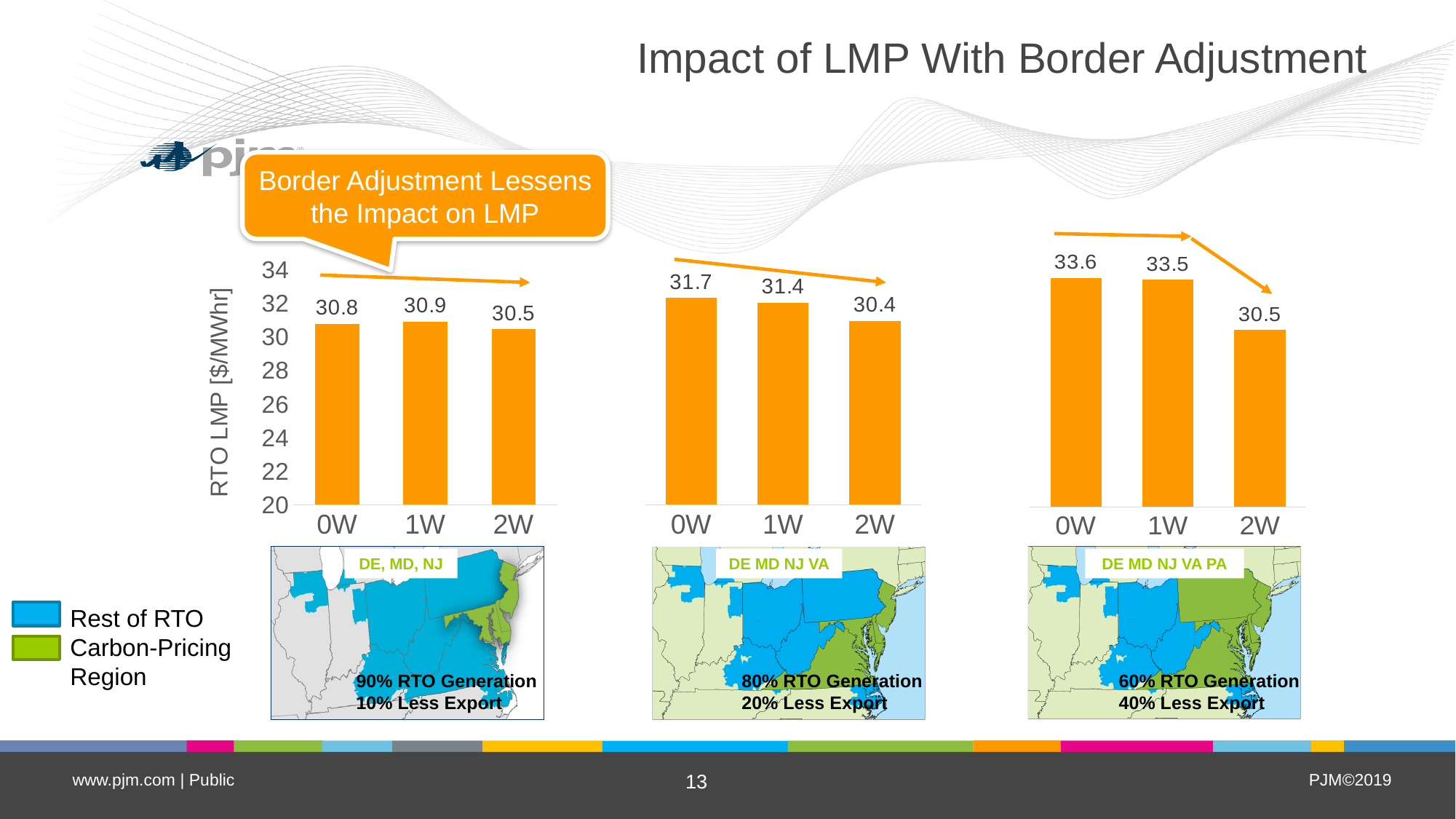
In the right chart (DE MD NJ VA PA), is the value for 1W greater or less than 32? greater How many categories are shown on the x axis of the left chart (DE, MD, NJ)? 3 What is the y-axis label of the charts on this slide? RTO LMP [$/MWhr] In the right chart (DE MD NJ VA PA), which category has the lowest RTO LMP? 2W In the middle chart (DE MD NJ VA), what is the difference between the RTO LMP for 0W and 1W? 0.3 In the middle chart (DE MD NJ VA), what is the RTO LMP for 2W? 30.4 What type of chart is used to show RTO LMP on this slide? Bar chart In the left chart (DE, MD, NJ), which category has the highest RTO LMP? 1W In the right chart (DE MD NJ VA PA), what is the RTO LMP for 0W? 33.6 In the middle chart (DE MD NJ VA), which is larger, the RTO LMP for 0W or 2W? 0W In the left chart (DE, MD, NJ), what is the RTO LMP for 0W? 30.8 In the right chart (DE MD NJ VA PA), what is the difference between the RTO LMP for 0W and 2W? 3.1